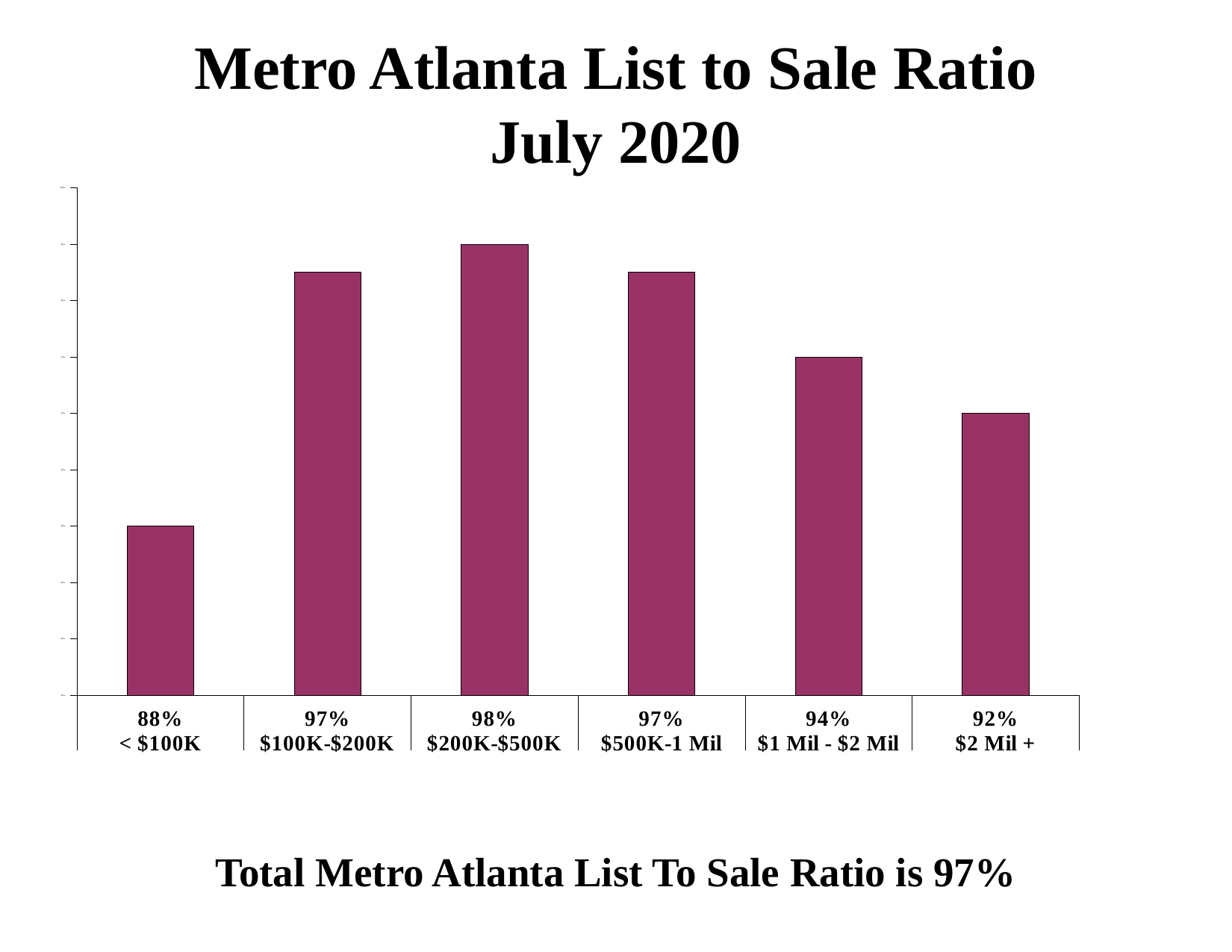
What is the list to sale ratio for the $2 Mil + price range? 92% Which price range has the lowest list to sale ratio? < $100K How many price ranges are shown in the chart? 6 What is the title of the chart? Metro Atlanta List to Sale Ratio July 2020 Which price range has the highest list to sale ratio? $200K-$500K What is the list to sale ratio for the $200K-$500K price range? 98% What is the list to sale ratio for homes under $100K? 88% According to the slide, what is the total Metro Atlanta list to sale ratio? 97% Which has a higher list to sale ratio, $1 Mil - $2 Mil or $2 Mil +? $1 Mil - $2 Mil What is the list to sale ratio for the $1 Mil - $2 Mil price range? 94% What is the difference in list to sale ratio between the $200K-$500K range and the < $100K range? 10% What kind of chart is shown on the slide? Bar chart